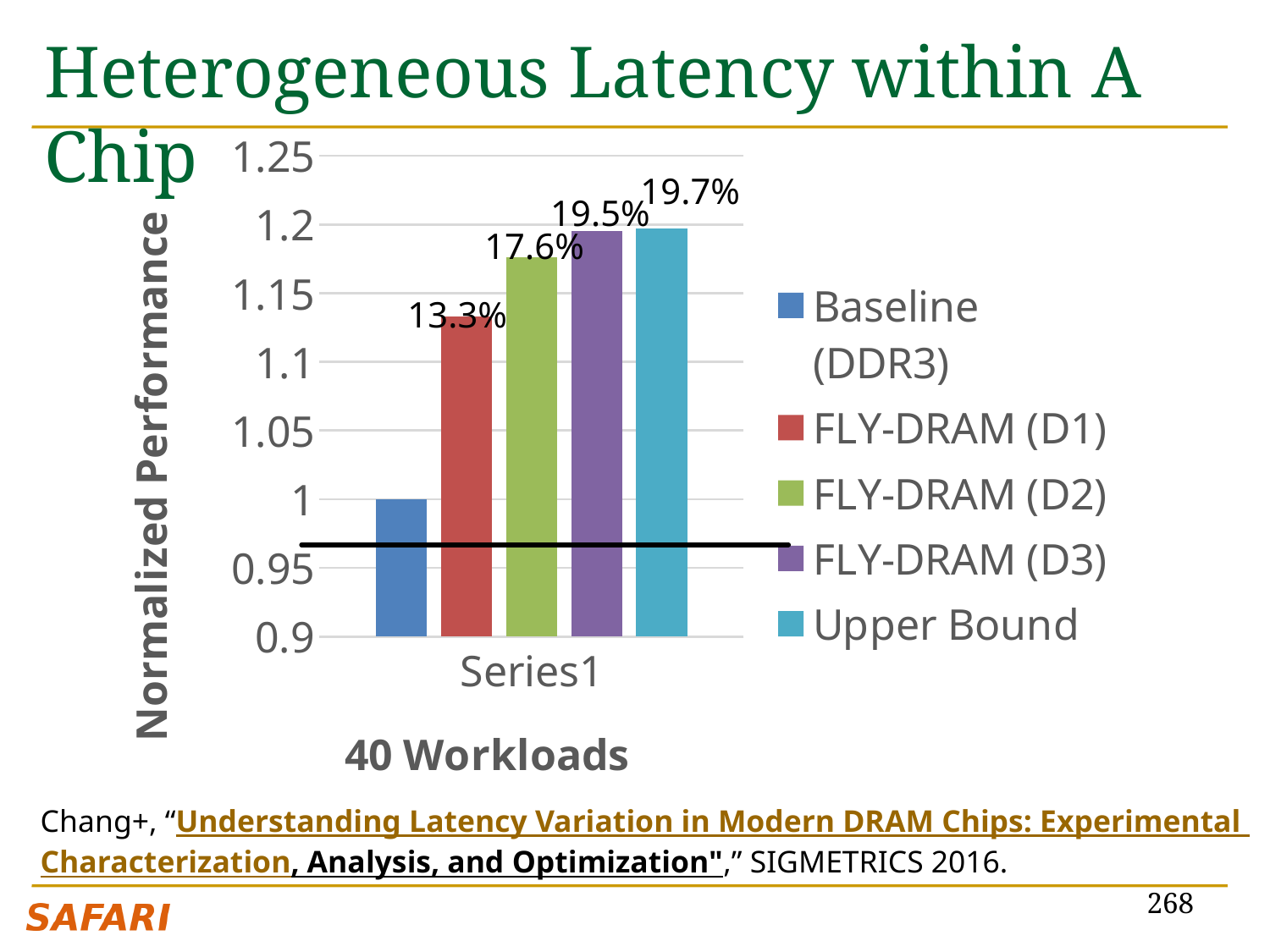
What percentage label is shown above the Upper Bound bar? 19.7% Which series has the tallest bar? Upper Bound Which series has the shortest bar? Baseline (DDR3) Which bar is taller, FLY-DRAM (D2) or FLY-DRAM (D1)? FLY-DRAM (D2) Is the normalized performance for FLY-DRAM (D1) greater or less than 1.1? greater What is the title of the vertical axis? Normalized Performance What normalized performance value does the Baseline (DDR3) bar reach? 1 How many series does the legend list? 5 What percentage label is shown above the FLY-DRAM (D3) bar? 19.5% What percentage label is shown above the FLY-DRAM (D1) bar? 13.3% What kind of chart is shown on the slide? Bar chart What percentage label is shown above the FLY-DRAM (D2) bar? 17.6%